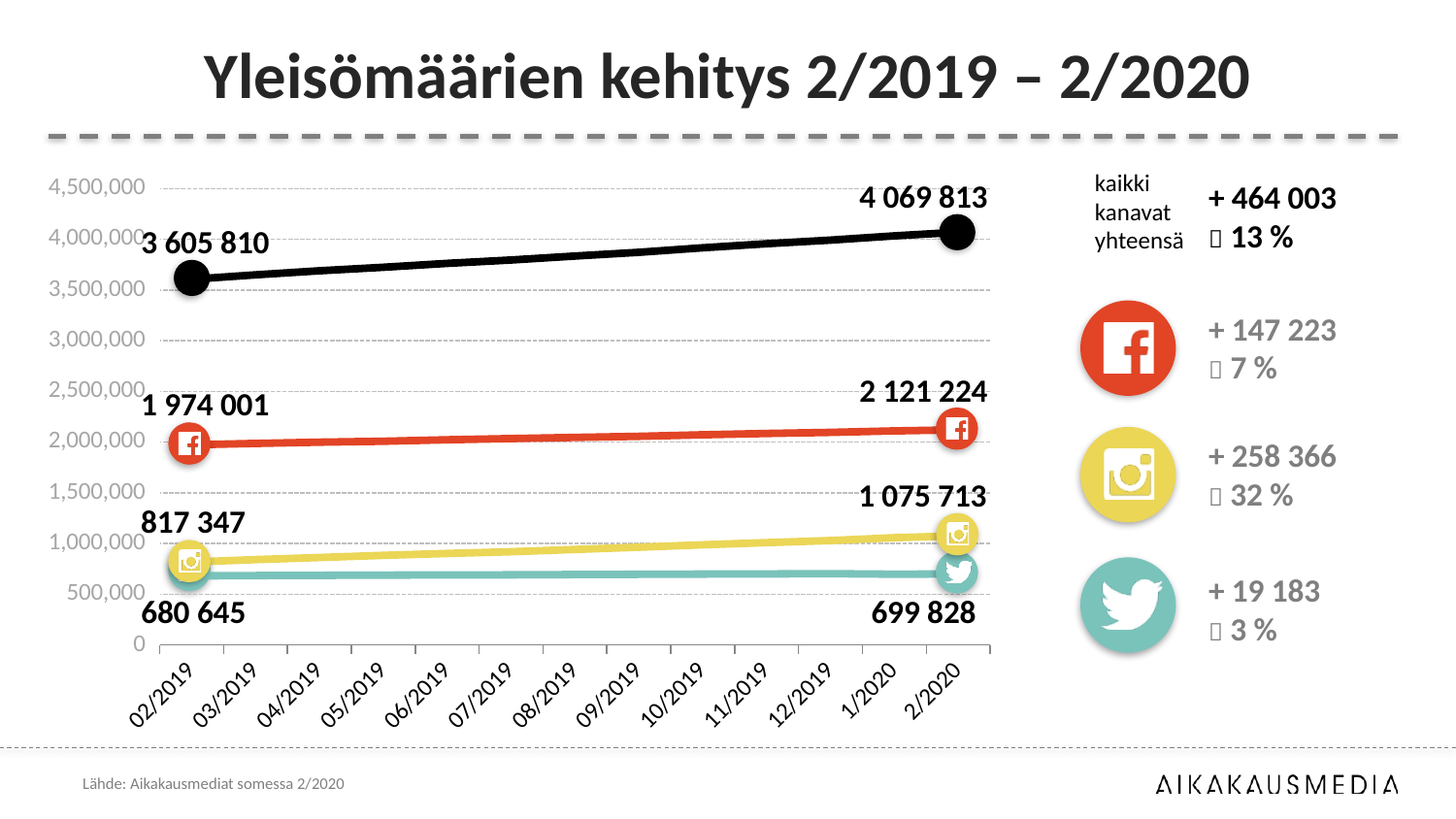
What type of chart is shown on the slide? line chart What is the value of the black (total) line at 2/2020? 4 069 813 Which line has the lowest value at 2/2020? Twitter (teal) line What is the value of the Instagram (yellow) line at 02/2019? 817 347 What is the title of the chart on the slide? Yleisömäärien kehitys 2/2019 – 2/2020 By how much did the Instagram (yellow) line increase from 02/2019 to 2/2020? 258 366 What is the value of the Facebook (red) line at 2/2020? 2 121 224 What is the value of the black (total) line at 02/2019? 3 605 810 How many months are shown on the x axis? 13 What is the value of the Twitter (teal) line at 2/2020? 699 828 Does the Facebook (red) line rise or fall from 02/2019 to 2/2020? rise By how much did the black (total) line increase from 02/2019 to 2/2020? 464 003